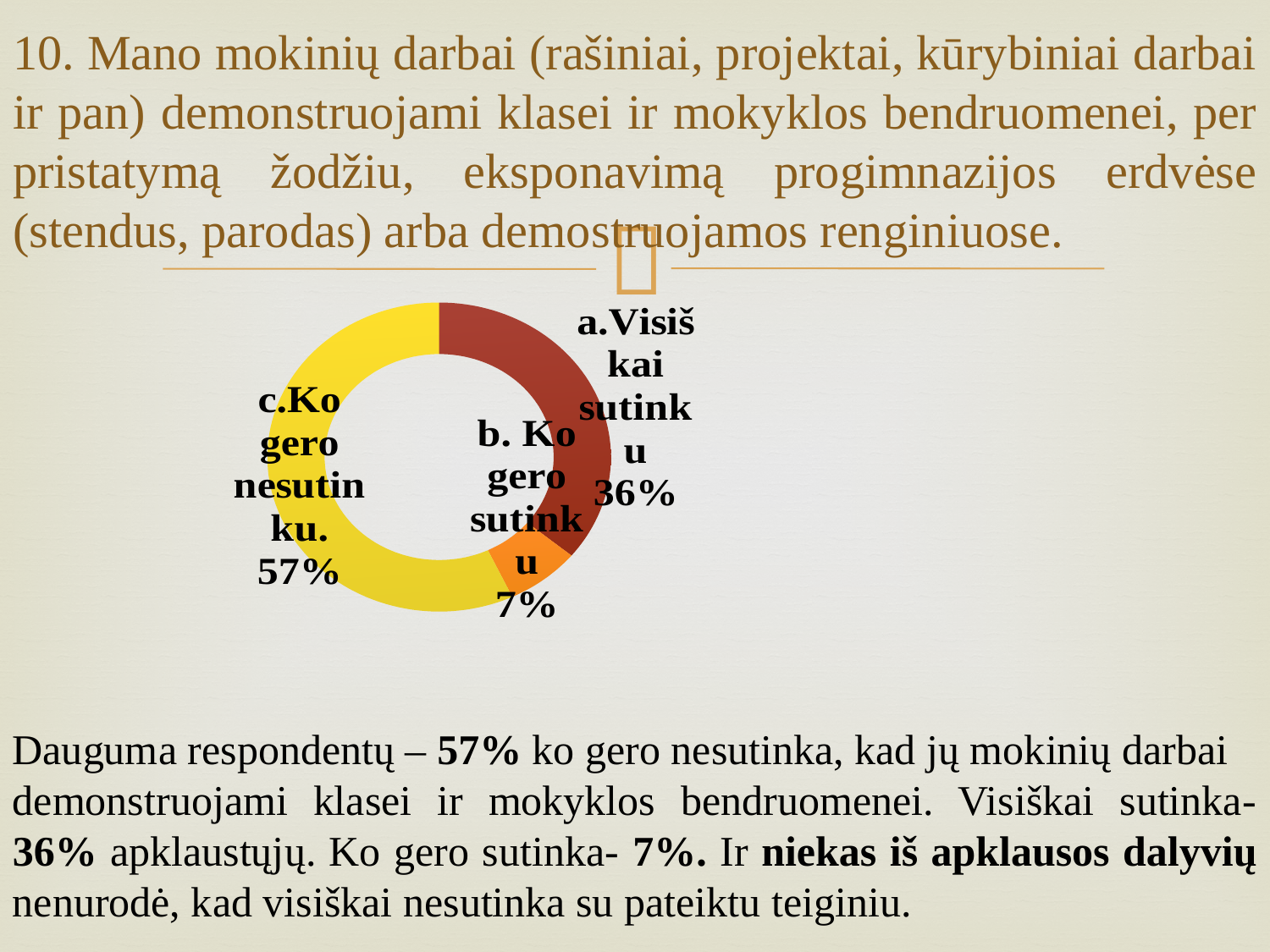
What percentage of respondents chose "c. Ko gero nesutinku"? 57% What colour is the slice for "a. Visiškai sutinku"? Dark red What percentage of respondents chose "b. Ko gero sutinku"? 7% What kind of chart is shown on the slide? Doughnut (pie) chart What is the difference in percentage points between "a. Visiškai sutinku" and "b. Ko gero sutinku"? 29 Which answer option has the smallest share of the chart? b. Ko gero sutinku What percentage of respondents chose "a. Visiškai sutinku"? 36% Which answer option has the largest share of the chart? c. Ko gero nesutinku Which is larger: the share for "a. Visiškai sutinku" or for "b. Ko gero sutinku"? a. Visiškai sutinku What colour is the slice for "c. Ko gero nesutinku"? Yellow What is the difference in percentage points between "c. Ko gero nesutinku" and "a. Visiškai sutinku"? 21 How many slices does the chart have? 3